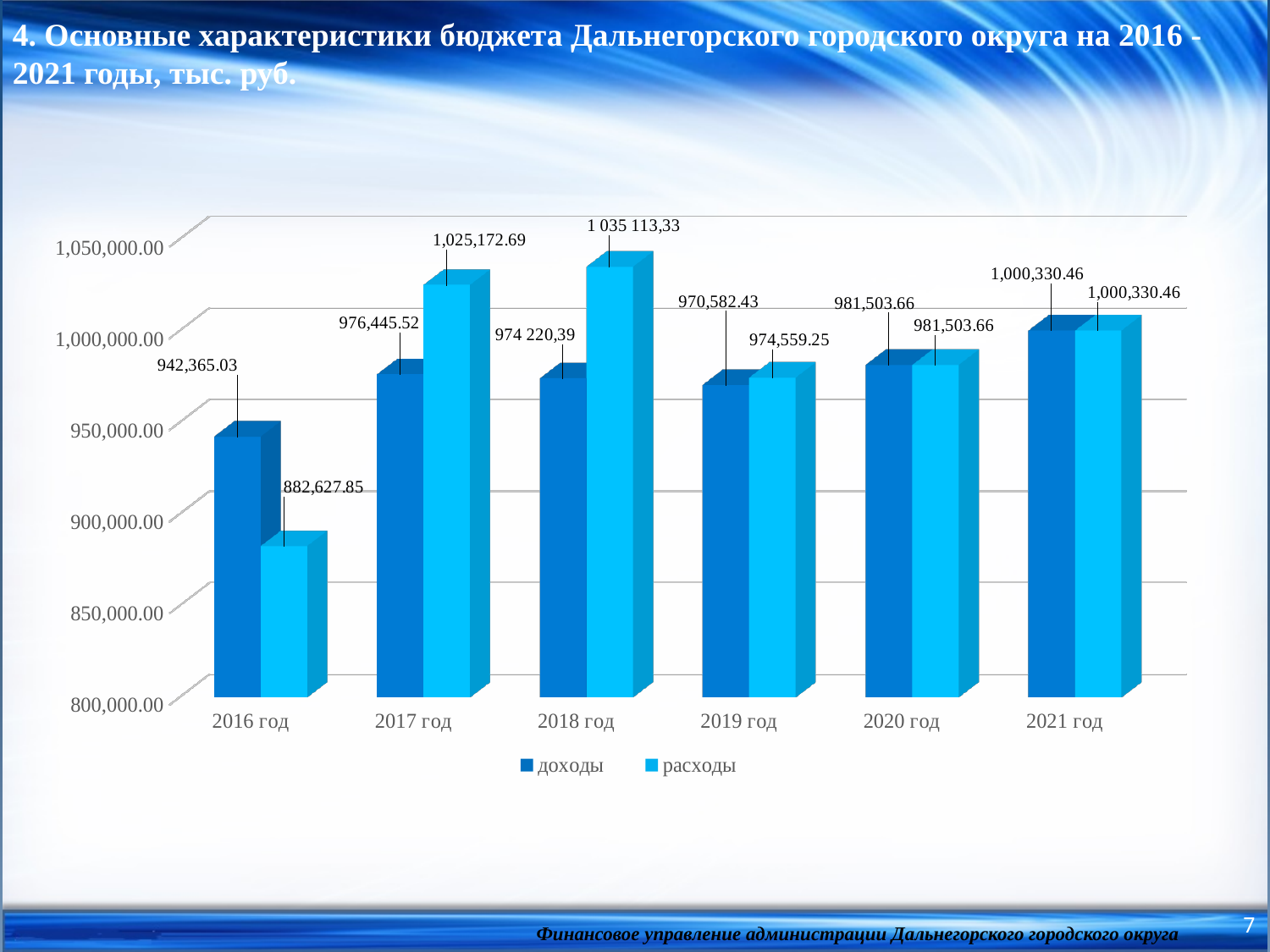
What is the value of расходы for 2017 год? 1,025,172.69 How many years are shown on the x axis? 6 What is the value of доходы for 2021 год? 1,000,330.46 What is the value of расходы for 2018 год? 1 035 113,33 How many series does the legend list? 2 In which year is доходы the lowest? 2016 год In which year is расходы the highest? 2018 год What kind of chart is shown on the slide? bar chart Which is larger in 2017 год, доходы or расходы? расходы What is the difference between доходы and расходы in 2016 год? 59,737.18 What is the value of доходы for 2016 год? 942,365.03 Is the value of расходы for 2016 год greater or less than 900,000.00? less